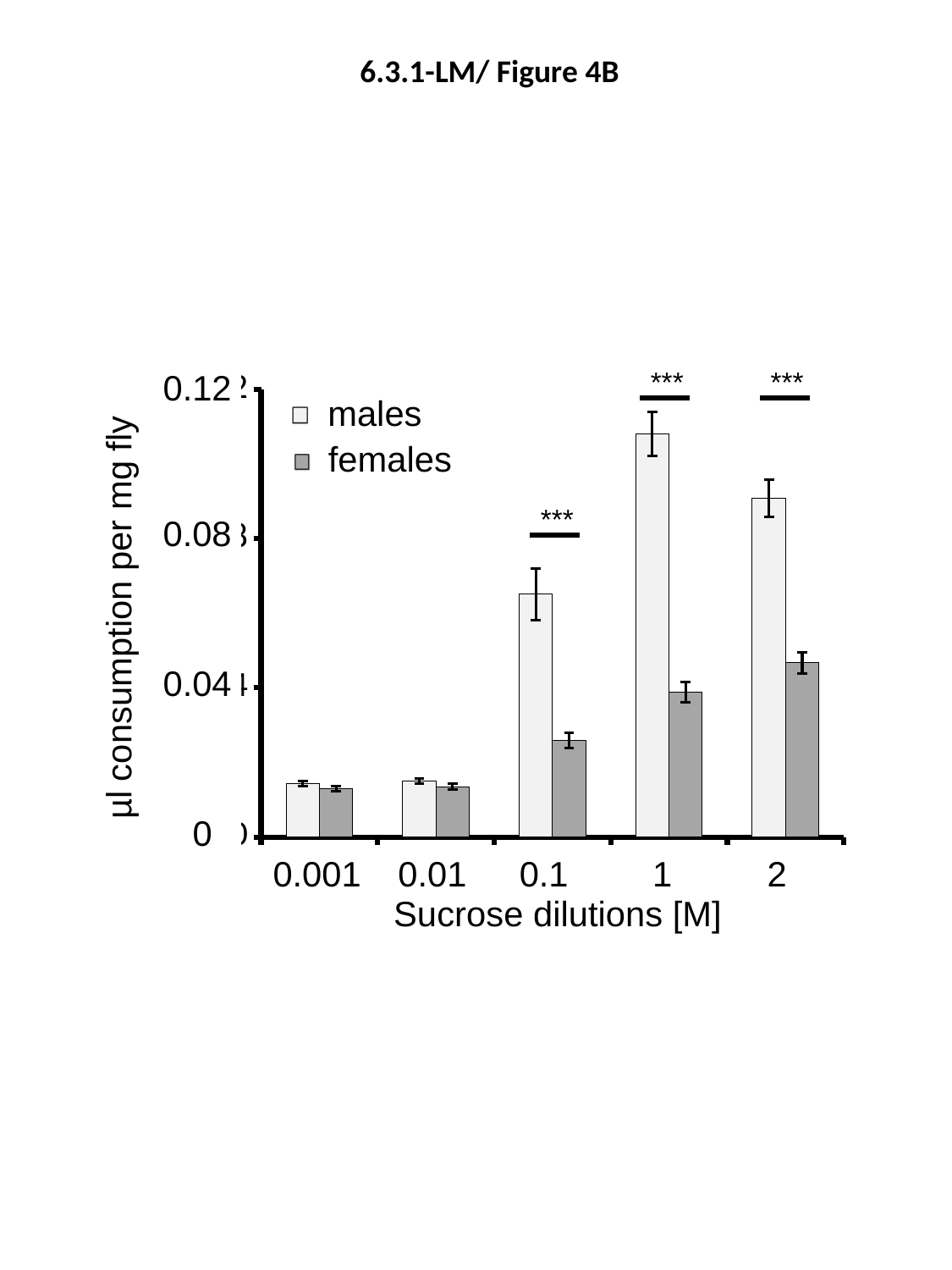
Is the males value at sucrose dilution 0.1 greater or less than 0.08? less What is the label of the y axis? µl consumption per mg fly Is the males value at sucrose dilution 1 greater or less than 0.08? greater At which sucrose dilution is the males value highest? 1 How many sucrose dilution categories are shown on the x axis? 5 Is the females value at sucrose dilution 0.1 greater or less than 0.04? less Do the females values generally rise or fall as the sucrose dilution increases along the x axis? rise How many series does the legend list? 2 At sucrose dilution 1, which series has the larger value, males or females? males What kind of chart is shown on the slide? bar chart At which sucrose dilution is the females value highest? 2